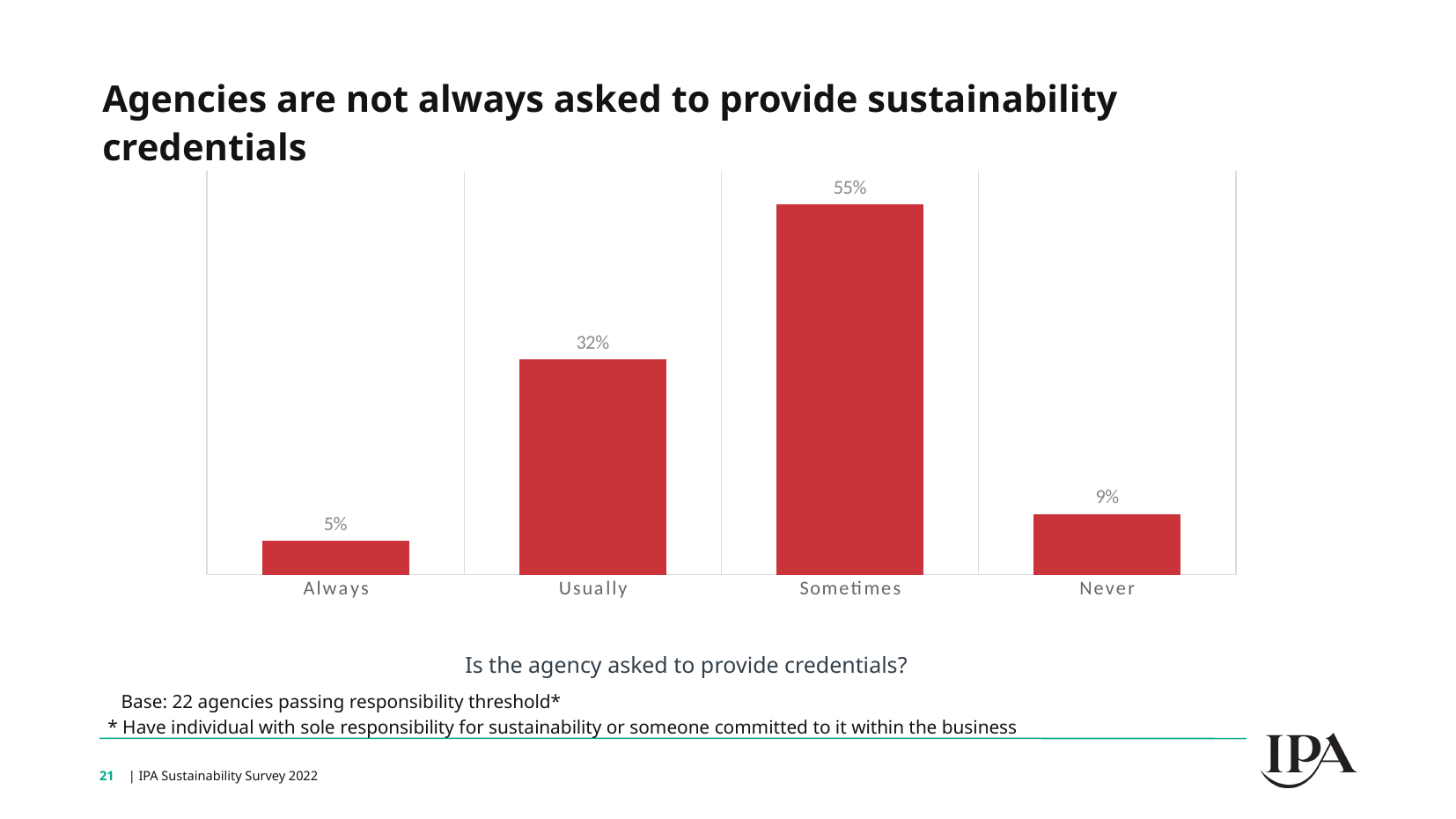
Which is larger, the value for 'Usually' or the value for 'Never'? Usually What question is written below the chart's x axis? Is the agency asked to provide credentials? What is the difference between the 'Sometimes' and 'Usually' values? 23% Which category has the highest value? Sometimes How many categories are shown on the x axis? 4 What is the value shown for 'Never'? 9% Which category has the lowest value? Always What is the value shown for 'Usually'? 32% What percentage of agencies are 'Sometimes' asked to provide credentials? 55% What kind of chart is shown on the slide? Bar chart What is the difference between the 'Never' and 'Always' values? 4% What is the value shown for 'Always'? 5%